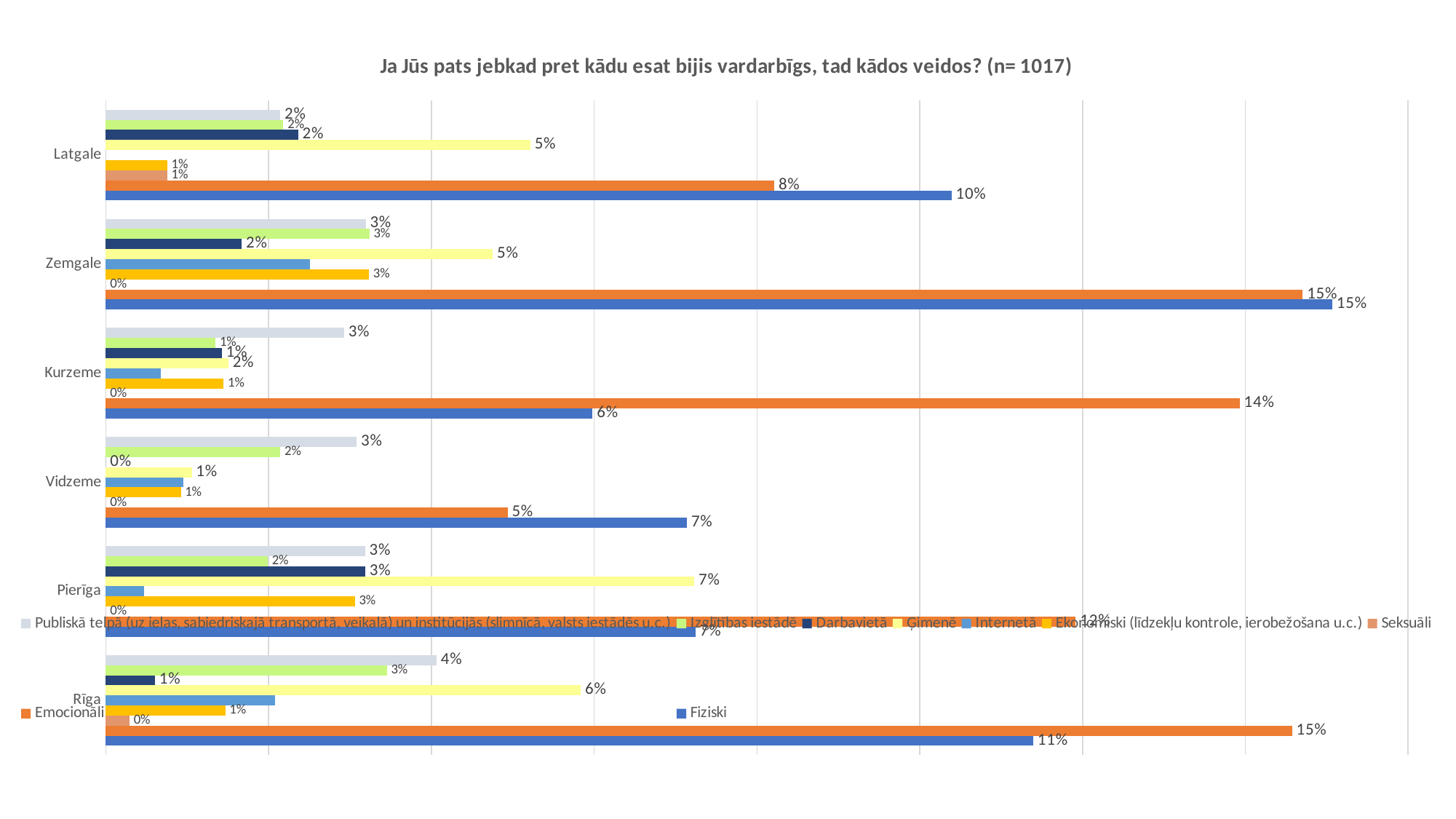
What kind of chart is shown on the slide? Bar chart What is the difference between the Fiziski values for Rīga and Vidzeme? 4 percentage points How many series does the legend list? 9 What is the value for Fiziski in Latgale? 10% How many regions are shown on the chart? 6 What is the value for Ģimenē in Latgale? 5% In Kurzeme, which is larger: Emocionāli or Fiziski? Emocionāli Which region has the lowest value for Fiziski? Kurzeme Which region has the highest value for Fiziski? Zemgale What is the value for Emocionāli in Kurzeme? 14% What is the value for Ģimenē in Pierīga? 7% What is the value for Publiskā telpā in Rīga? 4%